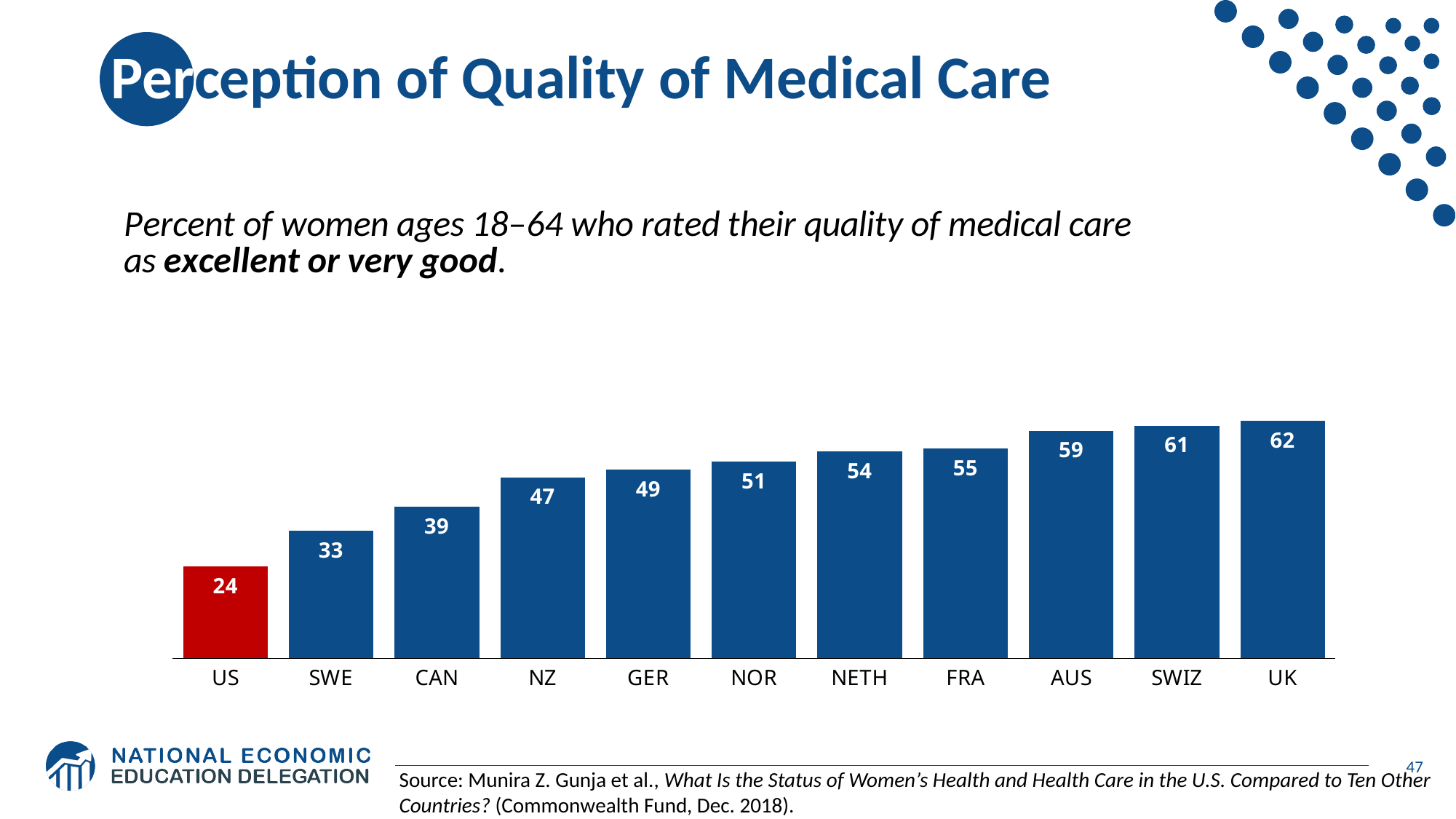
Which is larger, the value for NOR or the value for NZ? NOR What is the value for GER? 49 What is the value for the US? 24 What is the difference between the values for CAN and SWE? 6 Which country has the highest value? UK What kind of chart is shown on the slide? bar chart Which bar is coloured red rather than blue? US Do the values rise or fall from left to right across the chart? rise What is the value for AUS? 59 How many countries are shown in the chart? 11 Which country has the lowest value? US What is the difference between the values for UK and US? 38